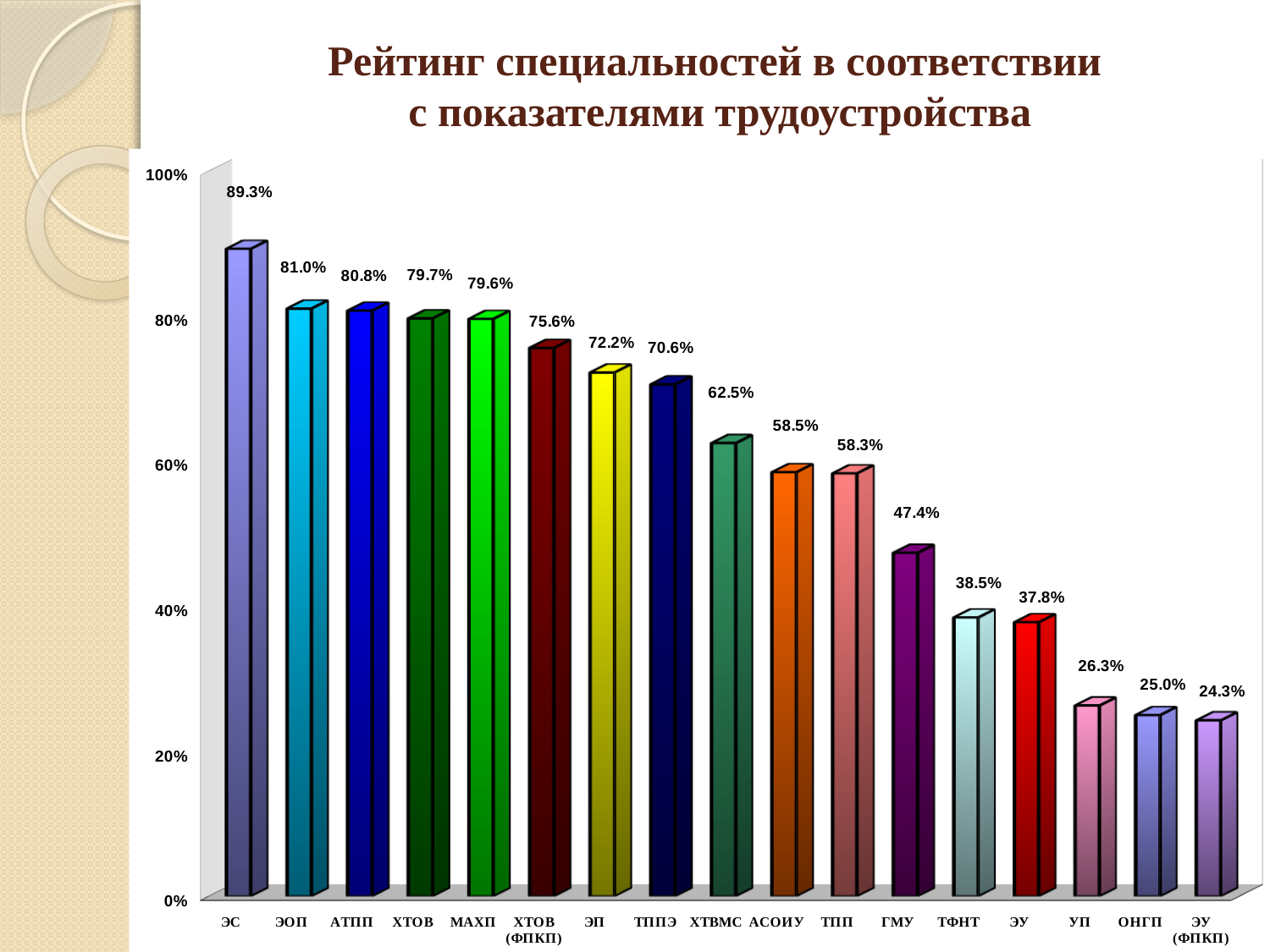
What is the value for ГМУ? 47.4% What is the difference between the values for ТФНТ and УП? 12.2% What is the difference between the values for ЭС and ЭОП? 8.3% Which category has the lowest value? ЭУ (ФПКП) What is the value for ЭС? 89.3% Is the value for ЭП greater or less than 60%? greater What kind of chart is shown on the slide? bar chart Do the values rise or fall from left to right along the x axis? fall What is the value for ХТОВ (ФПКП)? 75.6% Which is larger, the value for ХТВМС or the value for ТПП? ХТВМС How many categories are shown on the x axis? 17 Which category has the highest value? ЭС